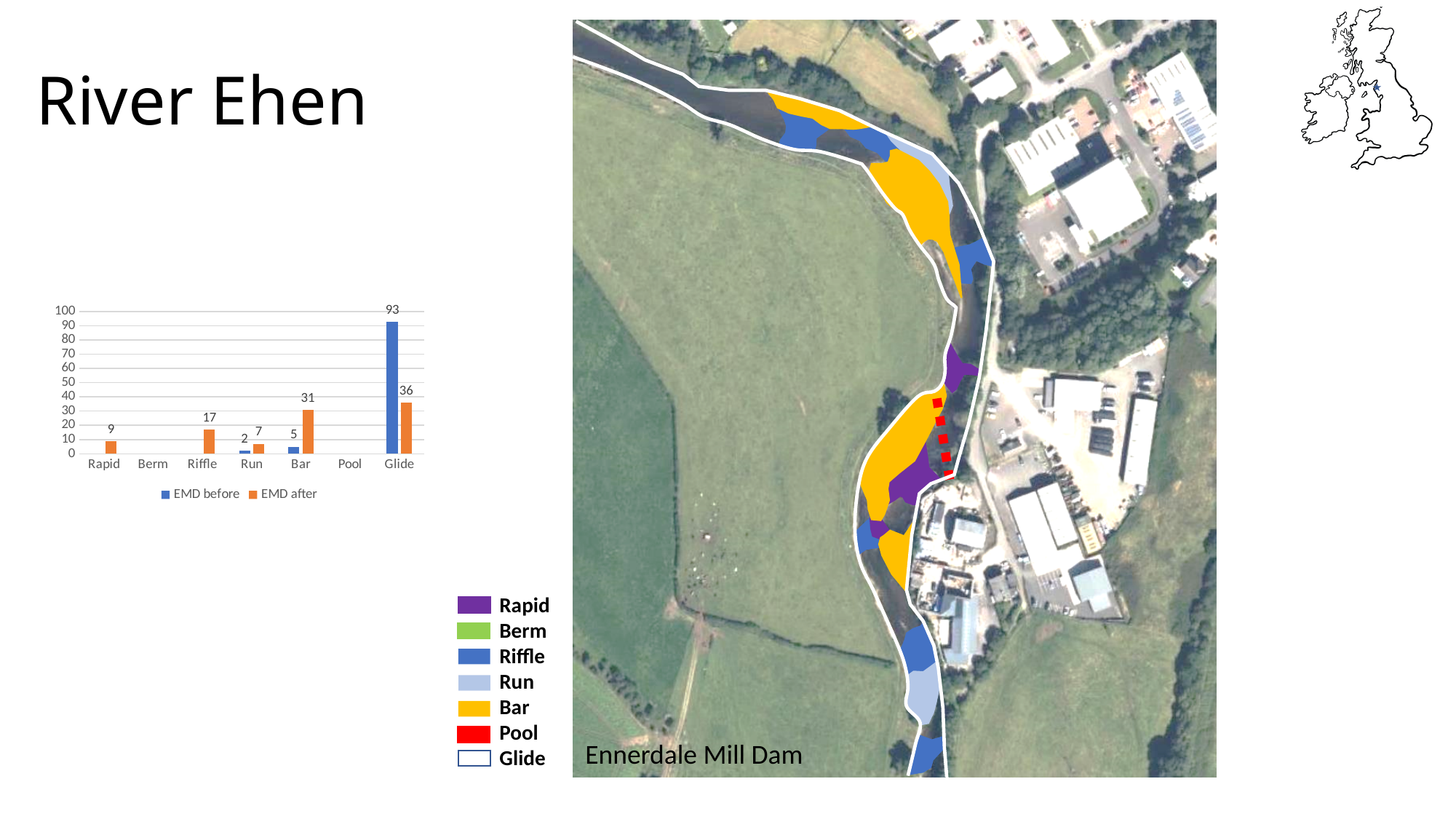
How many categories are shown on the x axis of the chart? 7 Which category has the highest EMD after value? Glide What is the EMD before value for Glide? 93 What is the EMD after value for Bar? 31 What is the EMD before value for Run? 2 What is the EMD after value for Riffle? 17 How many series does the chart legend list? 2 What is the difference between the EMD before and EMD after values for Glide? 57 What kind of chart is shown on the slide? Bar chart What is the EMD after value for Glide? 36 Which category has the highest EMD before value? Glide Which is larger for Bar: EMD before or EMD after? EMD after